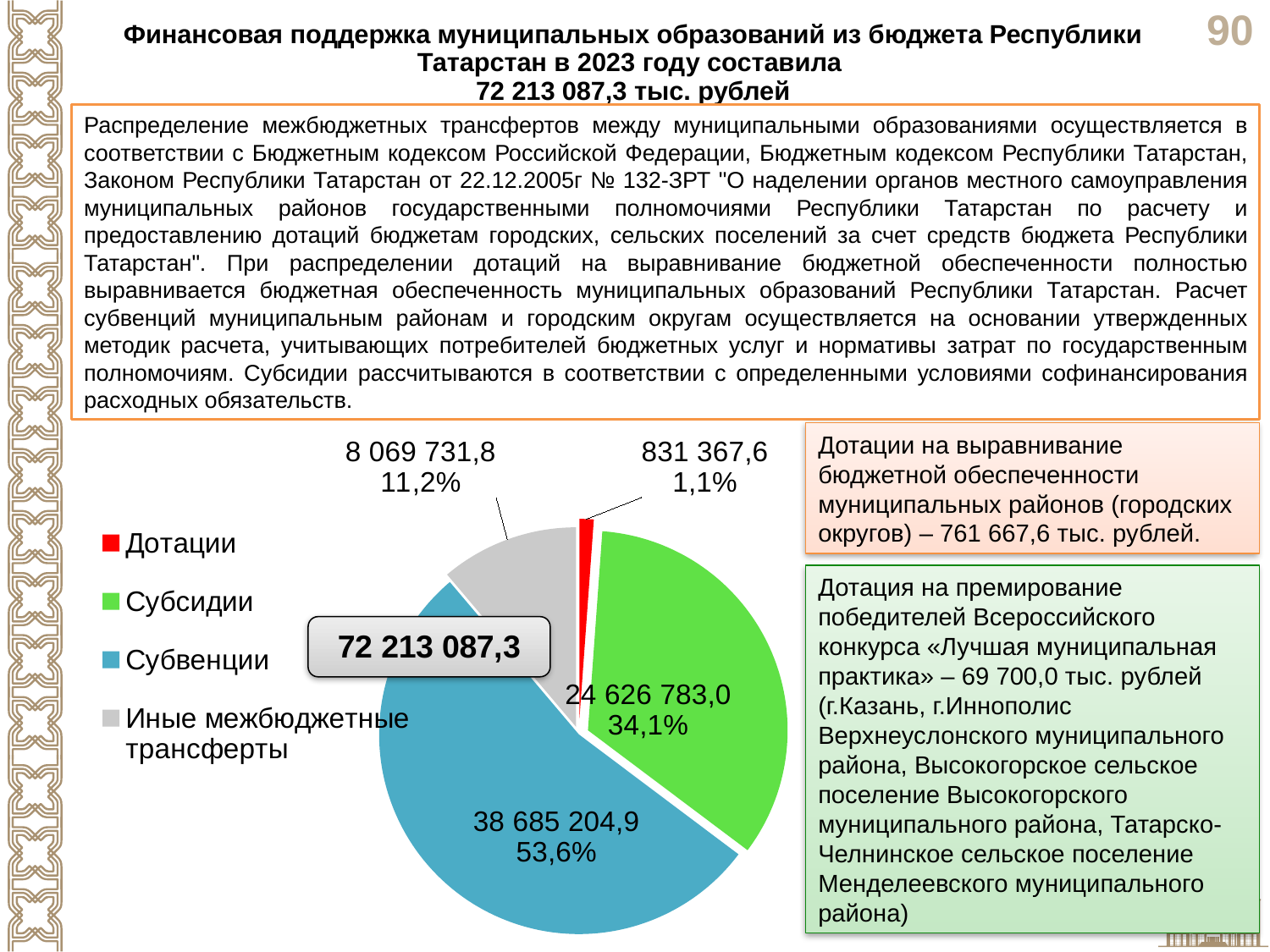
Which is larger in the pie chart, Субсидии or Иные межбюджетные трансферты? Субсидии How many entries does the legend of the pie chart list? 4 What kind of chart is shown on the slide? pie chart Which category has the smallest slice in the pie chart? Дотации What value is shown for Дотации in the pie chart? 831 367,6 What value is shown for Субвенции in the pie chart? 38 685 204,9 What share of the pie does Субсидии represent? 34,1% How many slices does the pie chart have? 4 What share of the pie does Иные межбюджетные трансферты represent? 11,2% What total value is shown in the box at the centre of the pie chart? 72 213 087,3 What is the difference in percentage points between the shares of Субвенции and Субсидии? 19,5 Which category has the largest slice in the pie chart? Субвенции